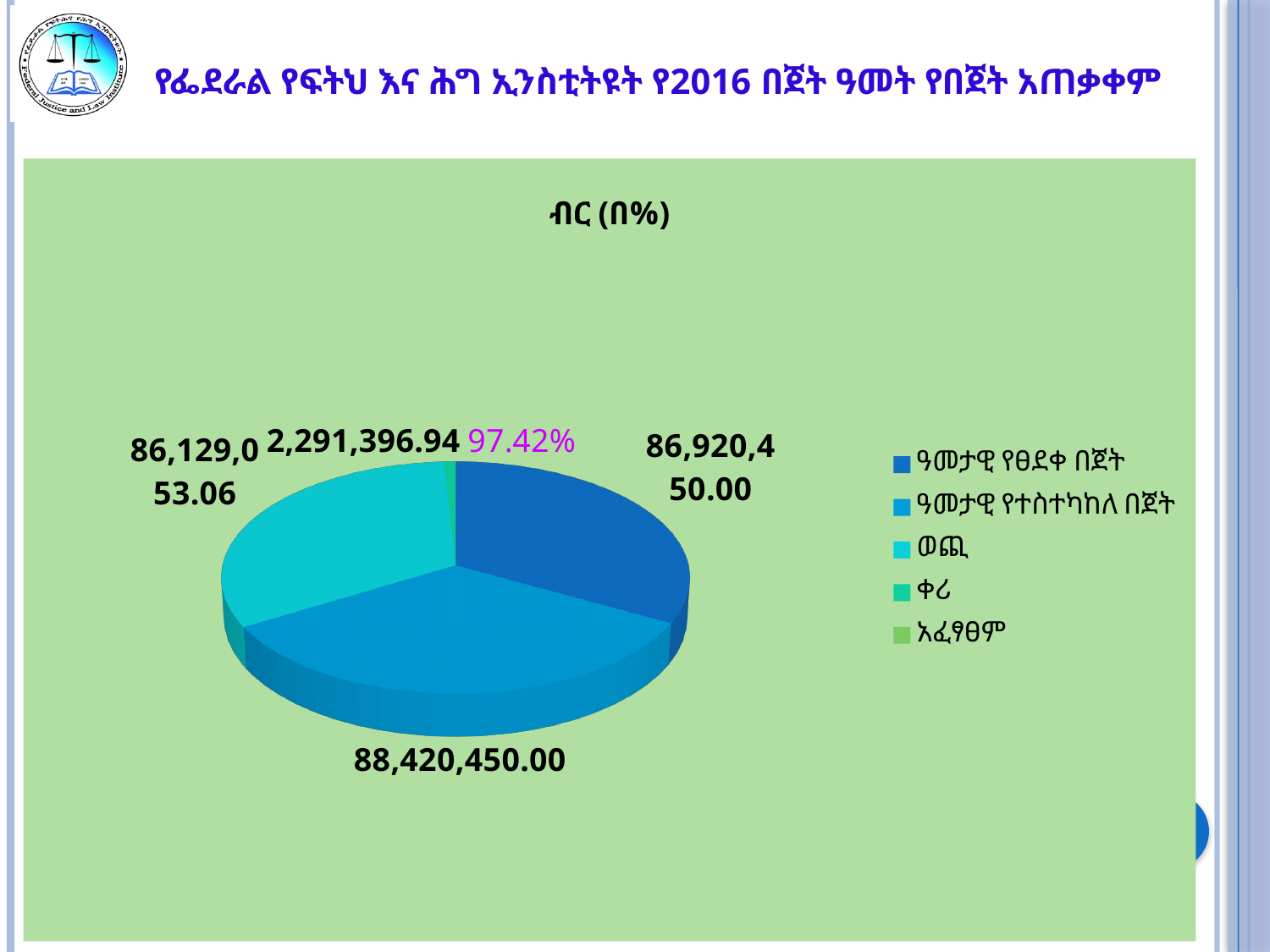
What is the value shown for ዓመታዊ የፀደቀ በጀት? 86,920,450.00 What is the value shown for አፈፃፀም? 97.42% Which category has the largest value in the chart? ዓመታዊ የተስተካከለ በጀት What is the difference between the value for ዓመታዊ የተስተካከለ በጀት and the value for ዓመታዊ የፀደቀ በጀት? 1,500,000.00 What is the value shown for ወጪ? 86,129,053.06 What is the title of the chart? ብር (በ%) What is the value shown for ቀሪ? 2,291,396.94 What is the value shown for ዓመታዊ የተስተካከለ በጀት? 88,420,450.00 What is the difference between the value for ዓመታዊ የፀደቀ በጀት and the value for ወጪ? 791,396.94 What type of chart is shown on the slide? Pie chart Which is larger, the value for ዓመታዊ የተስተካከለ በጀት or the value for ዓመታዊ የፀደቀ በጀት? ዓመታዊ የተስተካከለ በጀት How many categories does the chart's legend list? 5